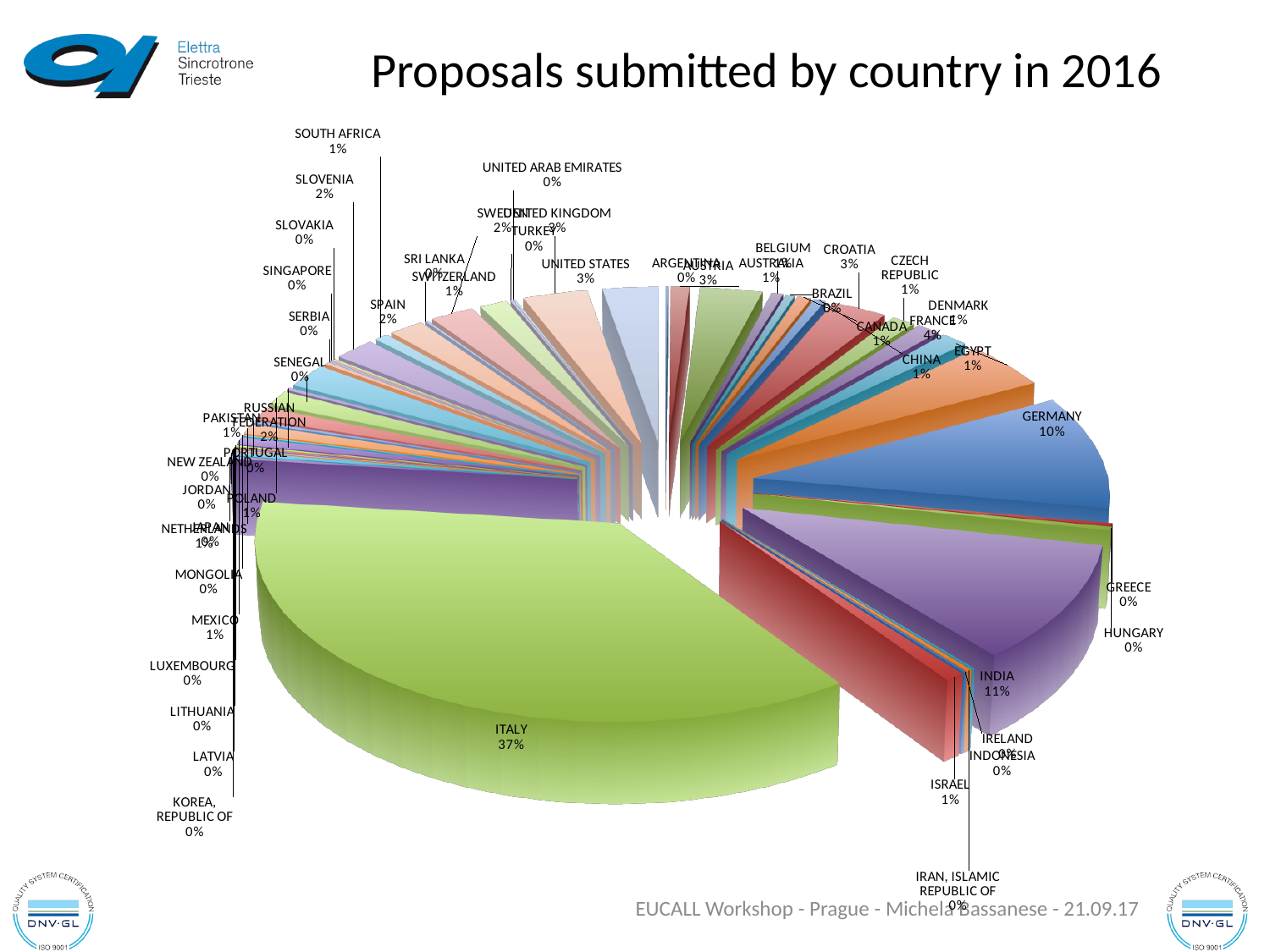
What is the title of the chart? Proposals submitted by country in 2016 What percentage of proposals was submitted by Spain? 2% What percentage of proposals was submitted by Croatia? 3% By how many percentage points does Italy's share exceed India's share? 26 percentage points What percentage of proposals was submitted by Slovenia? 2% What percentage of proposals was submitted by Germany? 10% What share of proposals was submitted by Italy? 37% Which has the larger share of proposals, Germany or India? INDIA Which country has the largest share of proposals submitted in 2016? ITALY What percentage of proposals was submitted by India? 11% What percentage of proposals was submitted by France? 4% What kind of chart is shown on the slide? Pie chart